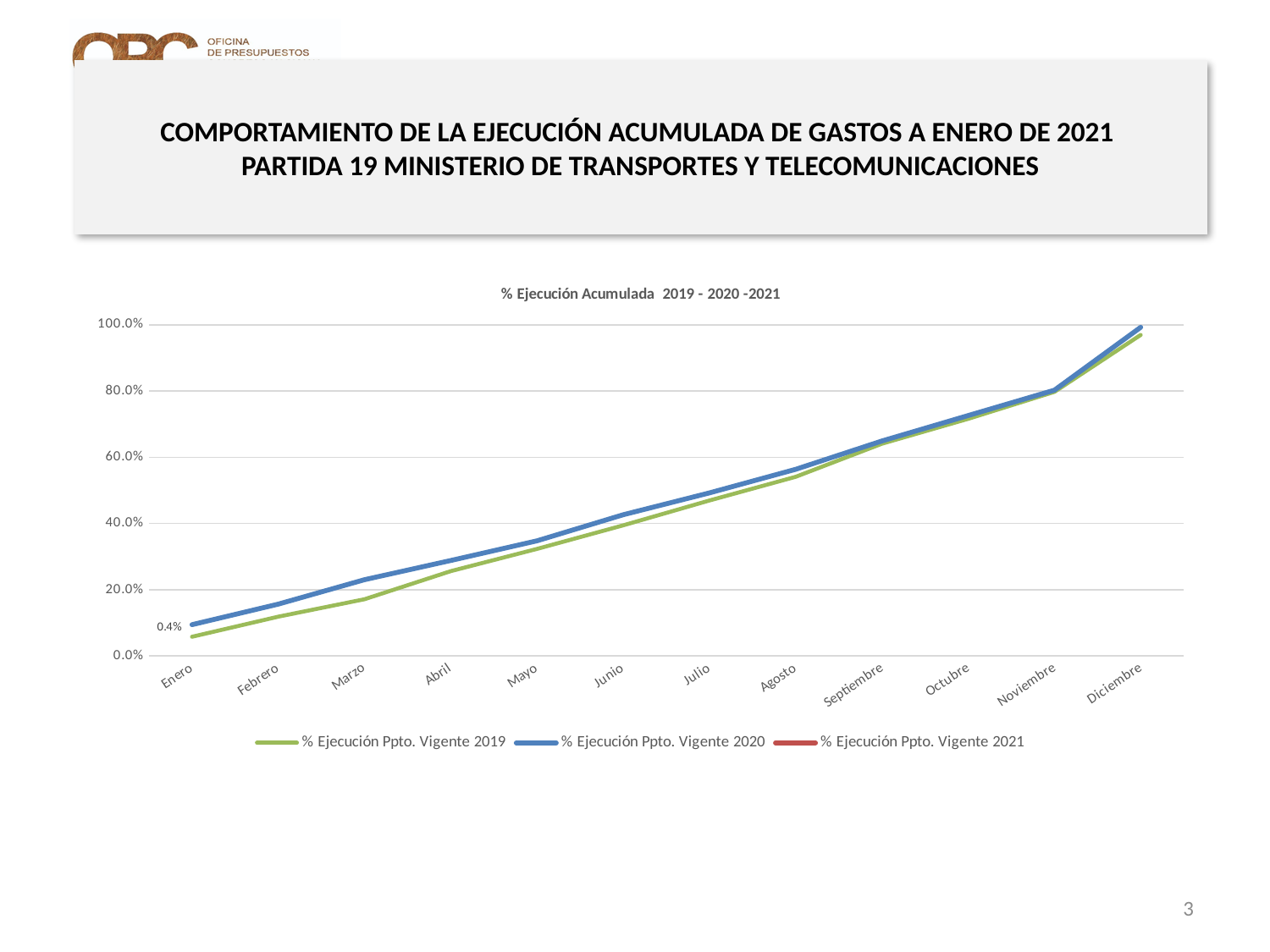
What kind of chart is shown on the slide? line chart Is the value for % Ejecución Ppto. Vigente 2019 in Agosto greater or less than 60.0%? less What is the value for % Ejecución Ppto. Vigente 2021 in Enero? 0.4% What colour is the line for % Ejecución Ppto. Vigente 2019? green Is the value for % Ejecución Ppto. Vigente 2020 in Noviembre greater or less than 60.0%? greater Is the value for % Ejecución Ppto. Vigente 2019 in Enero greater or less than 20.0%? less How many months are shown along the x axis? 12 How many series does the legend list? 3 What is the title of the chart? % Ejecución Acumulada 2019 - 2020 -2021 Do the values for % Ejecución Ppto. Vigente 2020 rise or fall from Enero to Diciembre? rise In Marzo, which series has the higher value: % Ejecución Ppto. Vigente 2019 or % Ejecución Ppto. Vigente 2020? % Ejecución Ppto. Vigente 2020